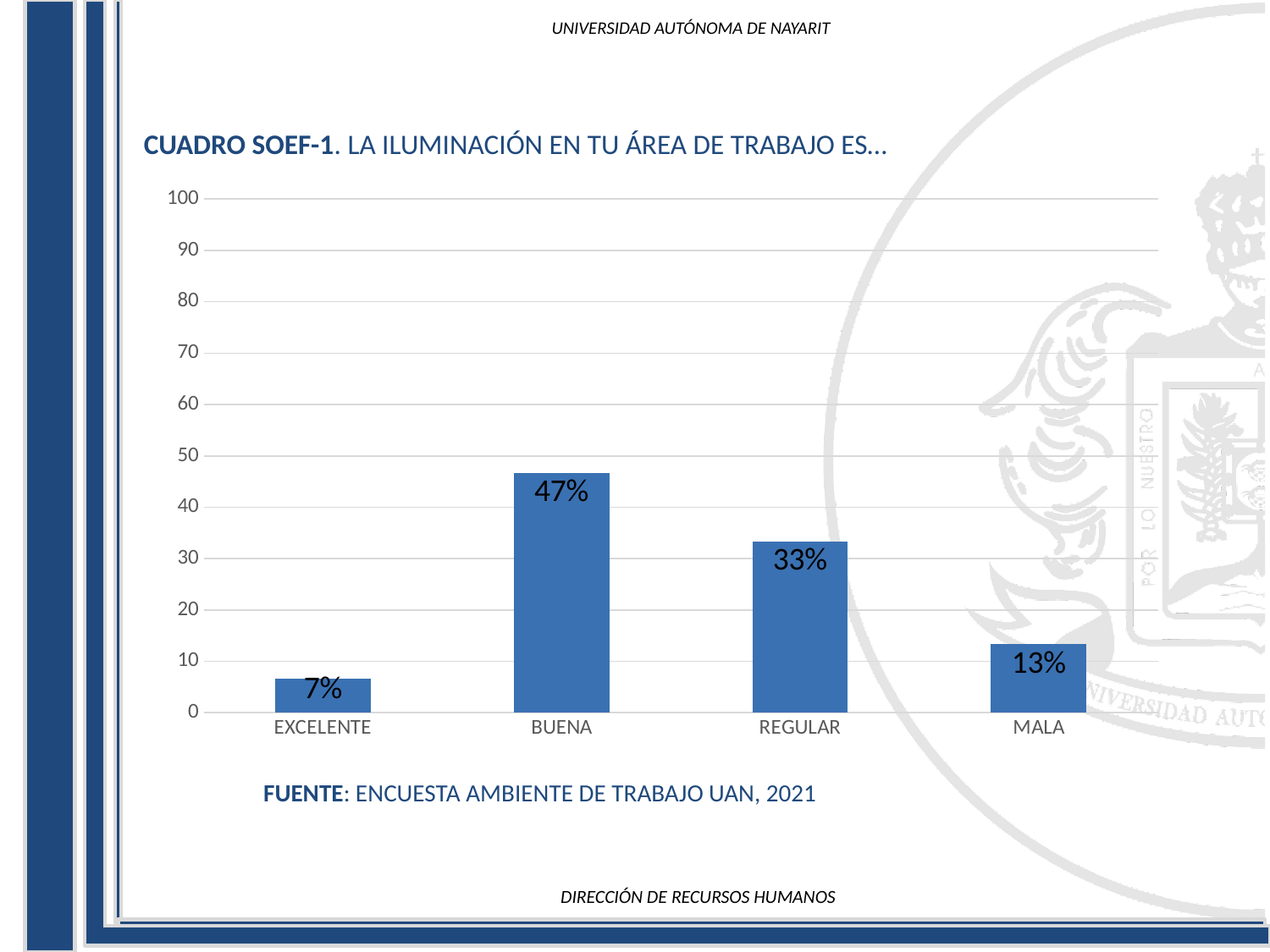
What is the value for EXCELENTE? 7% Is the value for REGULAR greater or less than 40? less What is the difference between the values for BUENA and REGULAR? 14% Which category has the highest value? BUENA Which category has the lowest value? EXCELENTE What is the value for BUENA? 47% Which is larger, the value for REGULAR or the value for MALA? REGULAR How many categories are shown on the x axis? 4 What kind of chart is shown on the slide? bar chart What is the title of the chart? CUADRO SOEF-1. LA ILUMINACIÓN EN TU ÁREA DE TRABAJO ES… What is the value for MALA? 13% What source is cited below the chart? ENCUESTA AMBIENTE DE TRABAJO UAN, 2021